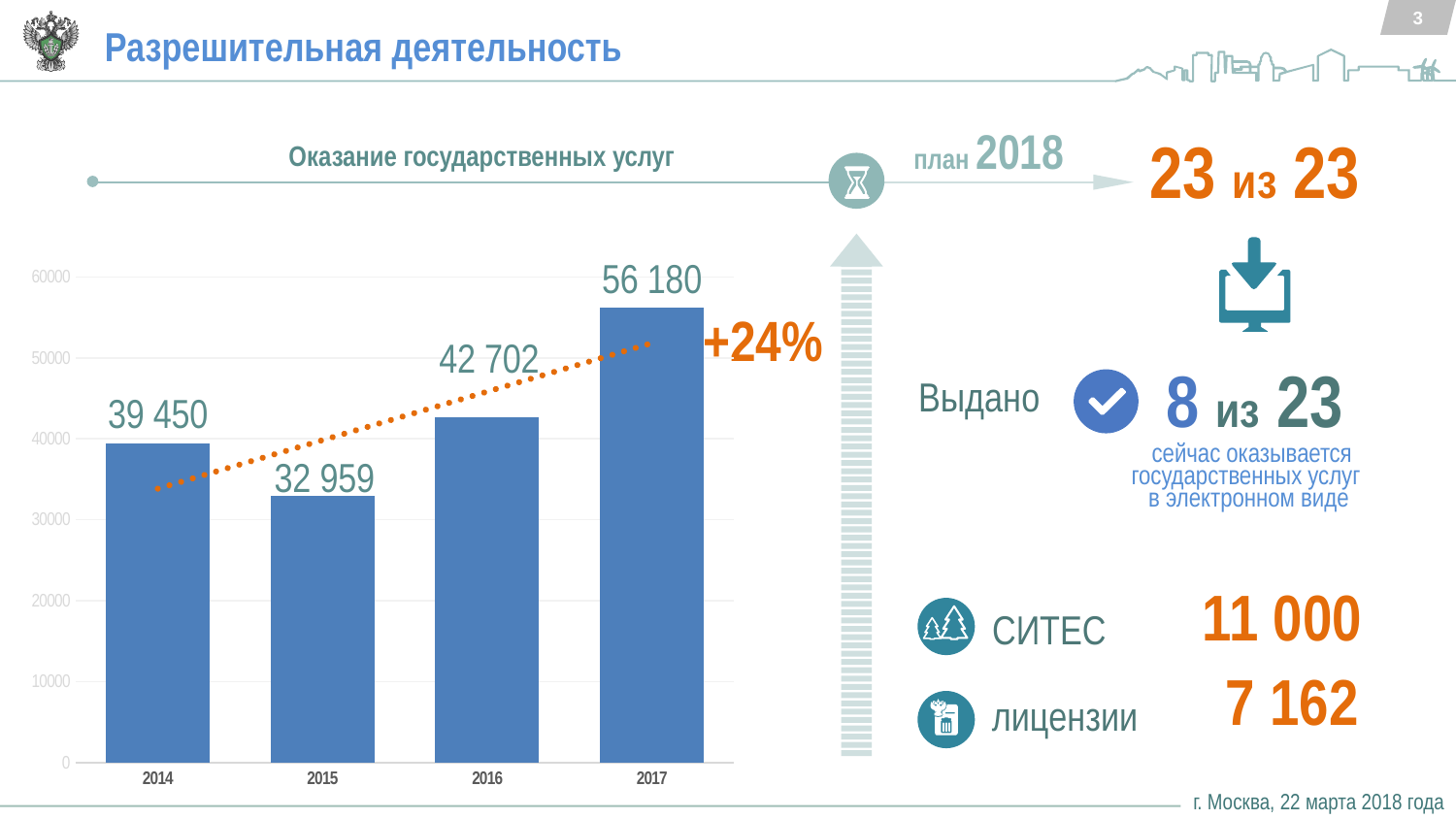
What is the title of the chart on the slide? Оказание государственных услуг Which year has the highest value in the chart? 2017 What is the value for 2014 in the chart? 39 450 What is the difference between the values for 2014 and 2015? 6 491 Which year has the lowest value in the chart? 2015 Which is larger, the value for 2014 or the value for 2016? 2016 What is the value for 2015 in the chart? 32 959 What is the value for 2017 in the chart 'Оказание государственных услуг'? 56 180 What is the value for 2016 in the chart? 42 702 How many years are shown on the x axis of the chart? 4 What kind of chart is shown on the slide? bar chart What is the difference between the values for 2017 and 2016? 13 478